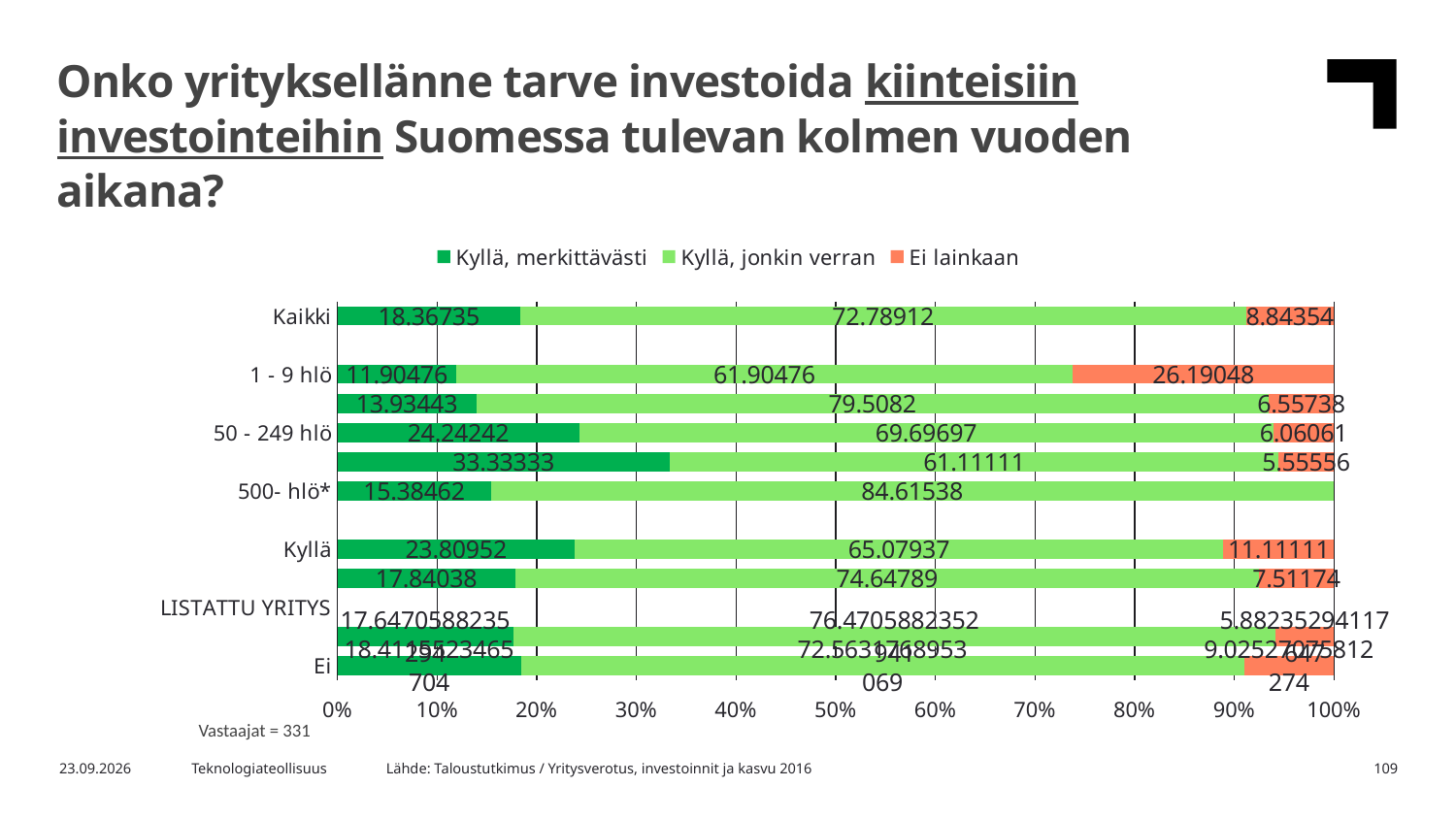
How many series does the legend list? 3 Which category has the highest "Kyllä, jonkin verran" value? 500- hlö* What is the value of "Kyllä, jonkin verran" for the 500- hlö* category? 84.61538 What is the value of "Ei lainkaan" for the 1 - 9 hlö category? 26.19048 Which is larger: the "Kyllä, merkittävästi" value for 50 - 249 hlö or for Kaikki? 50 - 249 hlö Which category has the highest "Ei lainkaan" value? 1 - 9 hlö What is the value of "Ei lainkaan" for the Kyllä category? 11.11111 For the Kaikki category, what is the difference between the "Kyllä, jonkin verran" value and the "Kyllä, merkittävästi" value? 54.42177 What kind of chart is shown on the slide? Stacked bar chart Which category has the lowest "Kyllä, merkittävästi" value? 1 - 9 hlö What is the value of "Kyllä, jonkin verran" for the Kaikki category? 72.78912 What is the value of "Kyllä, merkittävästi" for the 50 - 249 hlö category? 24.24242